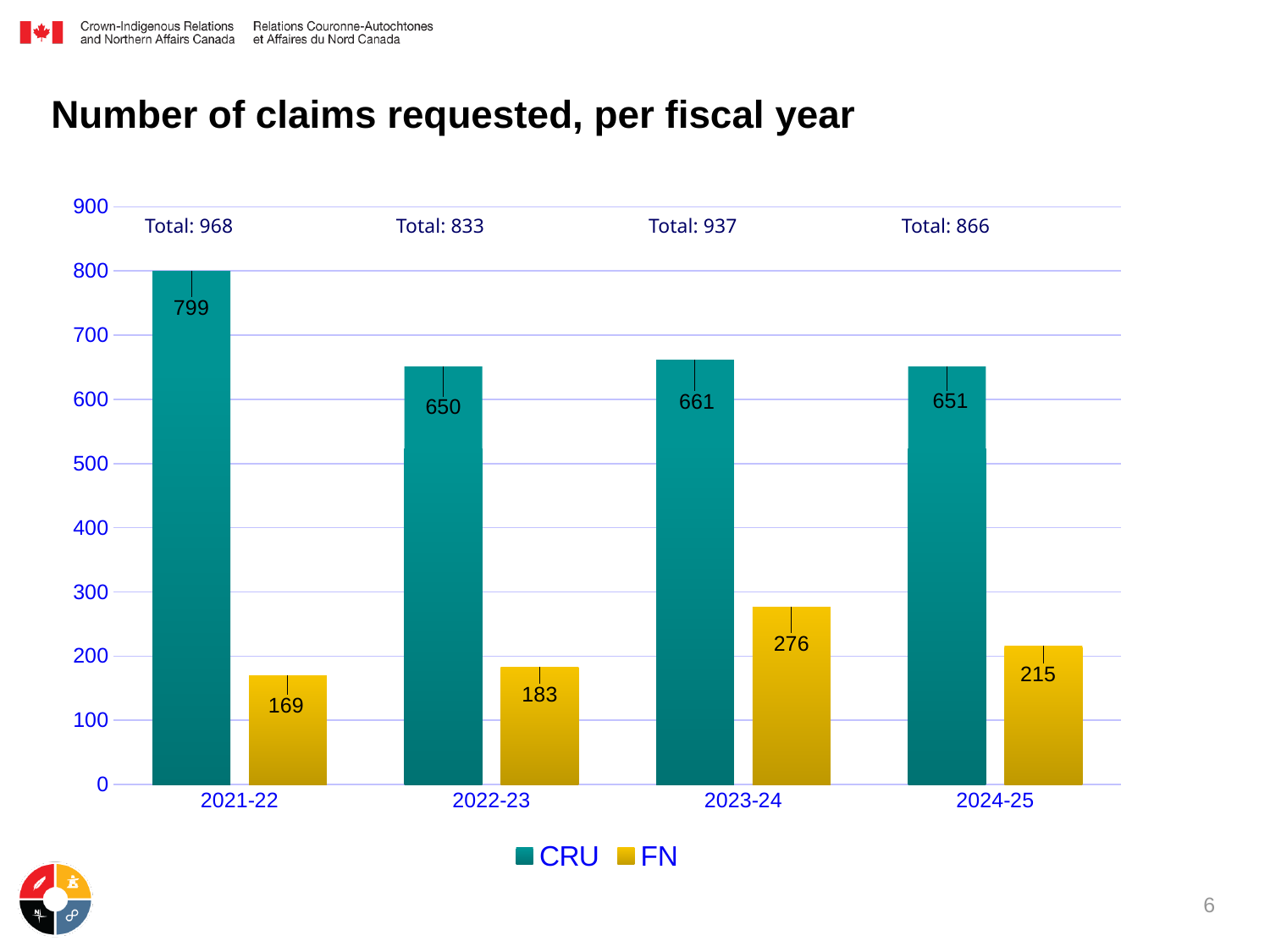
Is the CRU value for 2023-24 greater or less than 600? greater Which fiscal year has the highest CRU value? 2021-22 Which is larger, the FN value for 2023-24 or the FN value for 2024-25? 2023-24 What kind of chart is shown on the slide? bar chart How many series does the legend list? 2 What is the CRU value for 2021-22? 799 What is the FN value for 2024-25? 215 What is the total number of claims shown for 2023-24? 937 How many fiscal years are shown on the x axis? 4 What is the FN value for 2023-24? 276 What is the difference between the CRU value and the FN value in 2022-23? 467 Which fiscal year has the lowest FN value? 2021-22